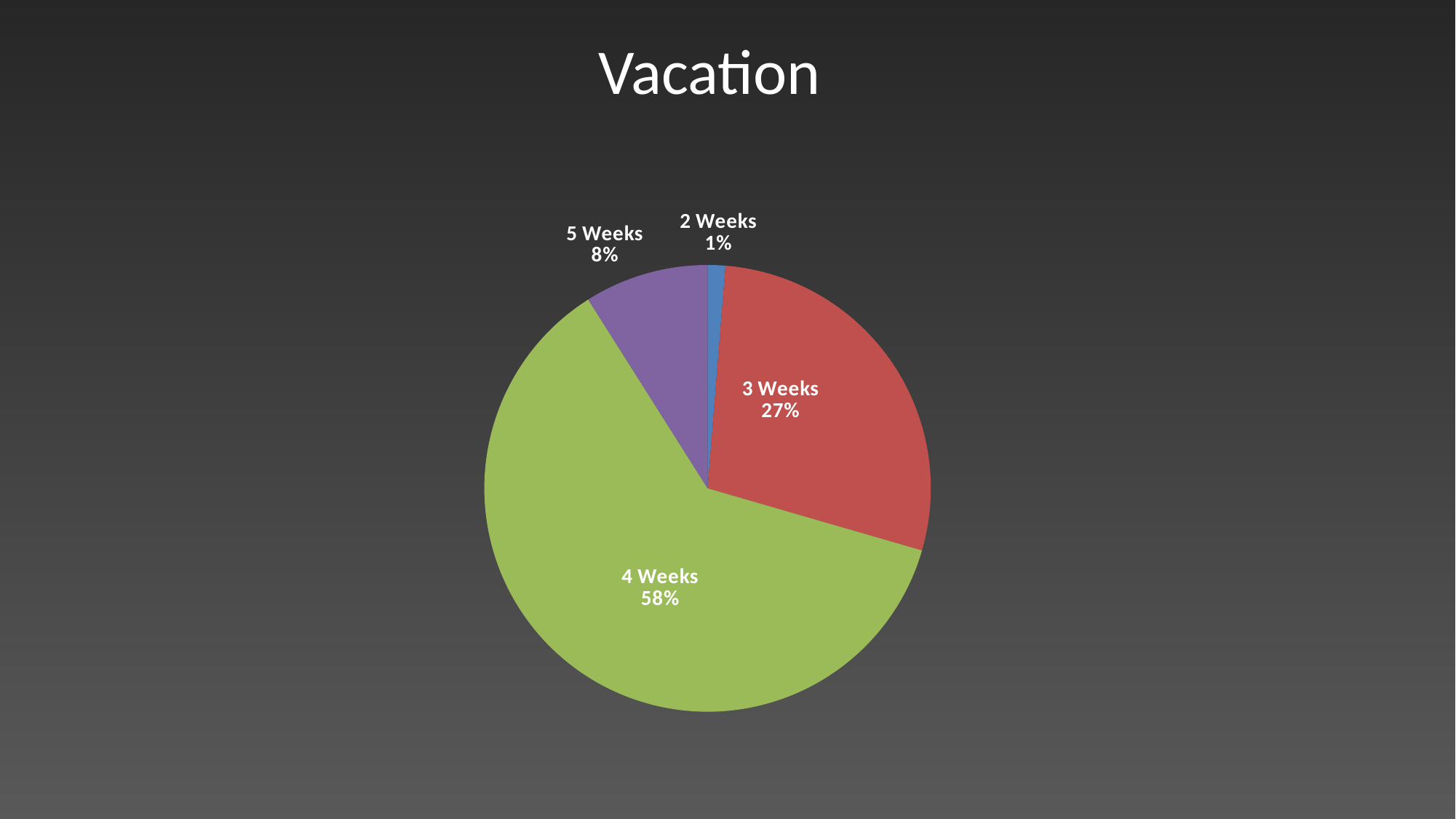
What share of the pie does 4 Weeks take? 58% Which slice is larger, 5 Weeks or 3 Weeks? 3 Weeks How many slices does the pie chart have? 4 Which category has the smallest slice of the pie? 2 Weeks Which category has the largest slice of the pie? 4 Weeks What share of the pie does 3 Weeks take? 27% What colour is the 4 Weeks slice? green What is the title of the chart? Vacation What share of the pie does 5 Weeks take? 8% What is the difference in percentage points between the 4 Weeks and 3 Weeks slices? 31 What kind of chart is shown on the slide? pie chart